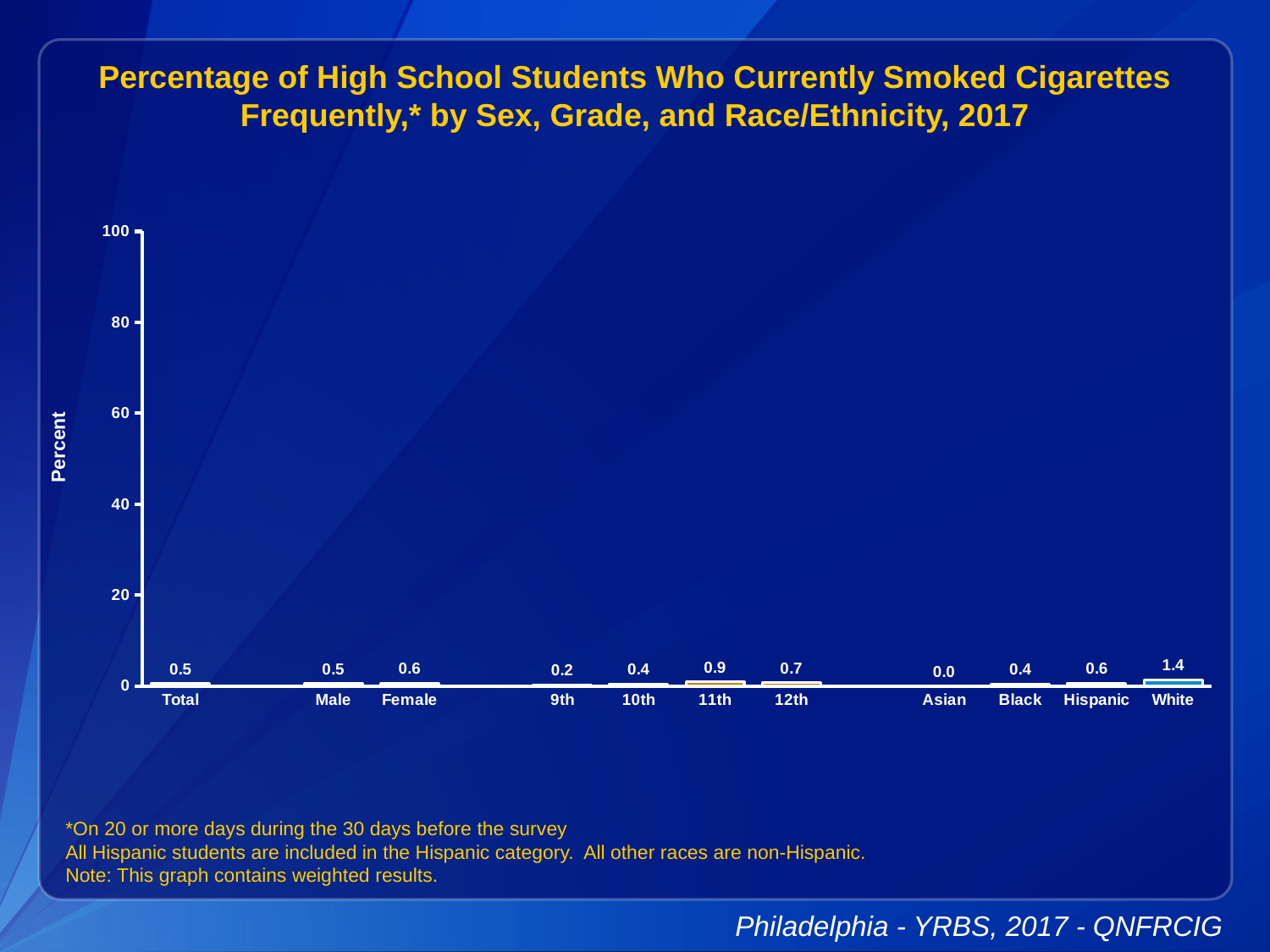
Which category has the highest value? White Which is larger, the value for 11th or 12th grade? 11th What is the value for Total? 0.5 What is the difference between the values for 11th and 9th grade? 0.7 What is the label on the y axis? Percent What is the value for White? 1.4 Which category has the lowest value? Asian What is the value for Female? 0.6 What is the value for 9th grade? 0.2 How many categories are shown on the x axis? 11 Is the value for White greater or less than 20? less What kind of chart is this? bar chart